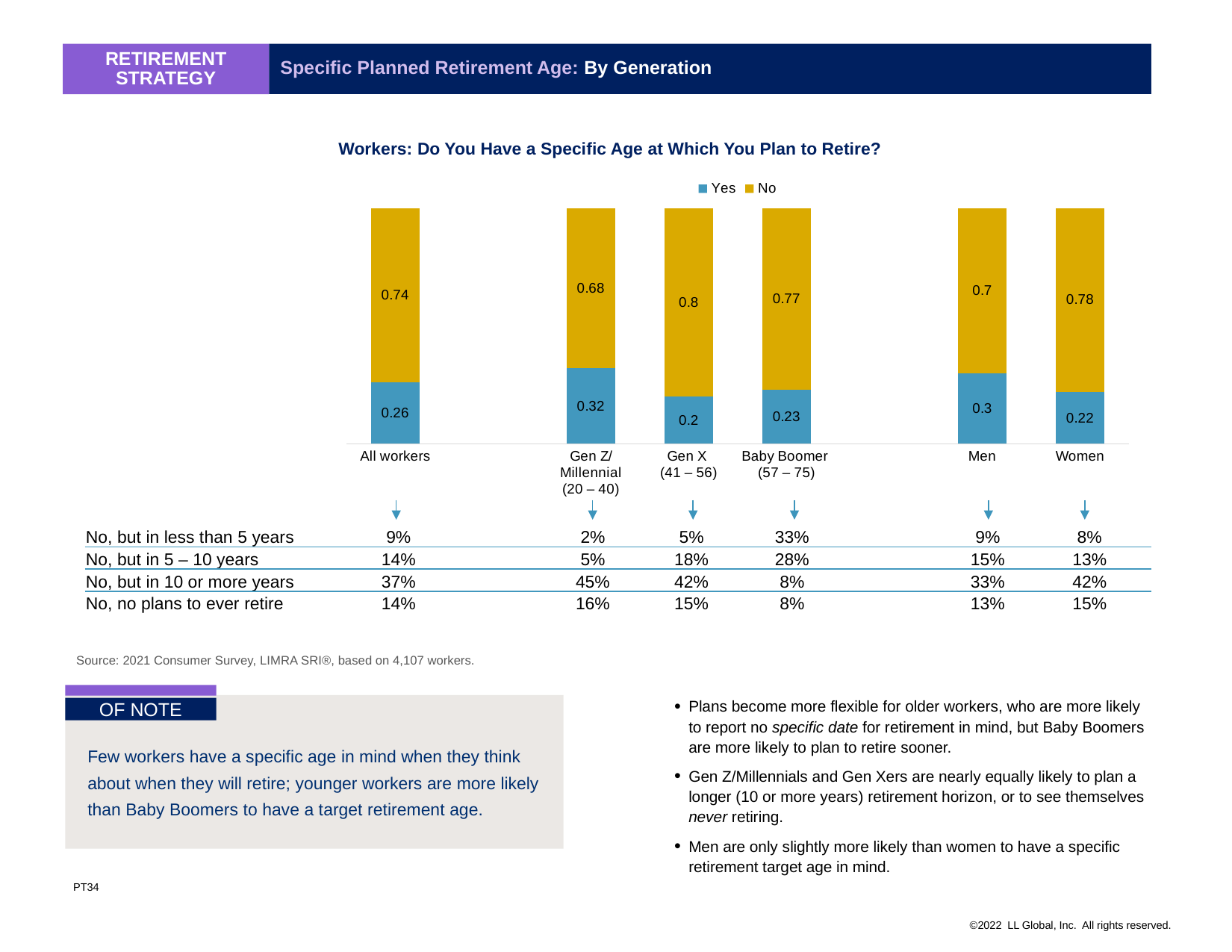
What is the difference between the "Yes" values for Men and Women? 0.08 Which category has the lowest "Yes" value? Gen X (41 – 56) Which has a larger "No" value, Gen Z/Millennial (20 – 40) or Baby Boomer (57 – 75)? Baby Boomer (57 – 75) What kind of chart is shown on the slide? Stacked bar chart How many series does the chart legend list? 2 What is the "Yes" value for Baby Boomer (57 – 75)? 0.23 What is the "Yes" value for All workers? 0.26 What is the "No" value for Women? 0.78 What is the title of the chart? Workers: Do You Have a Specific Age at Which You Plan to Retire? Which category has the highest "Yes" value? Gen Z/Millennial (20 – 40) What is the "No" value for Gen X (41 – 56)? 0.8 How many categories are shown on the x axis of the chart? 6